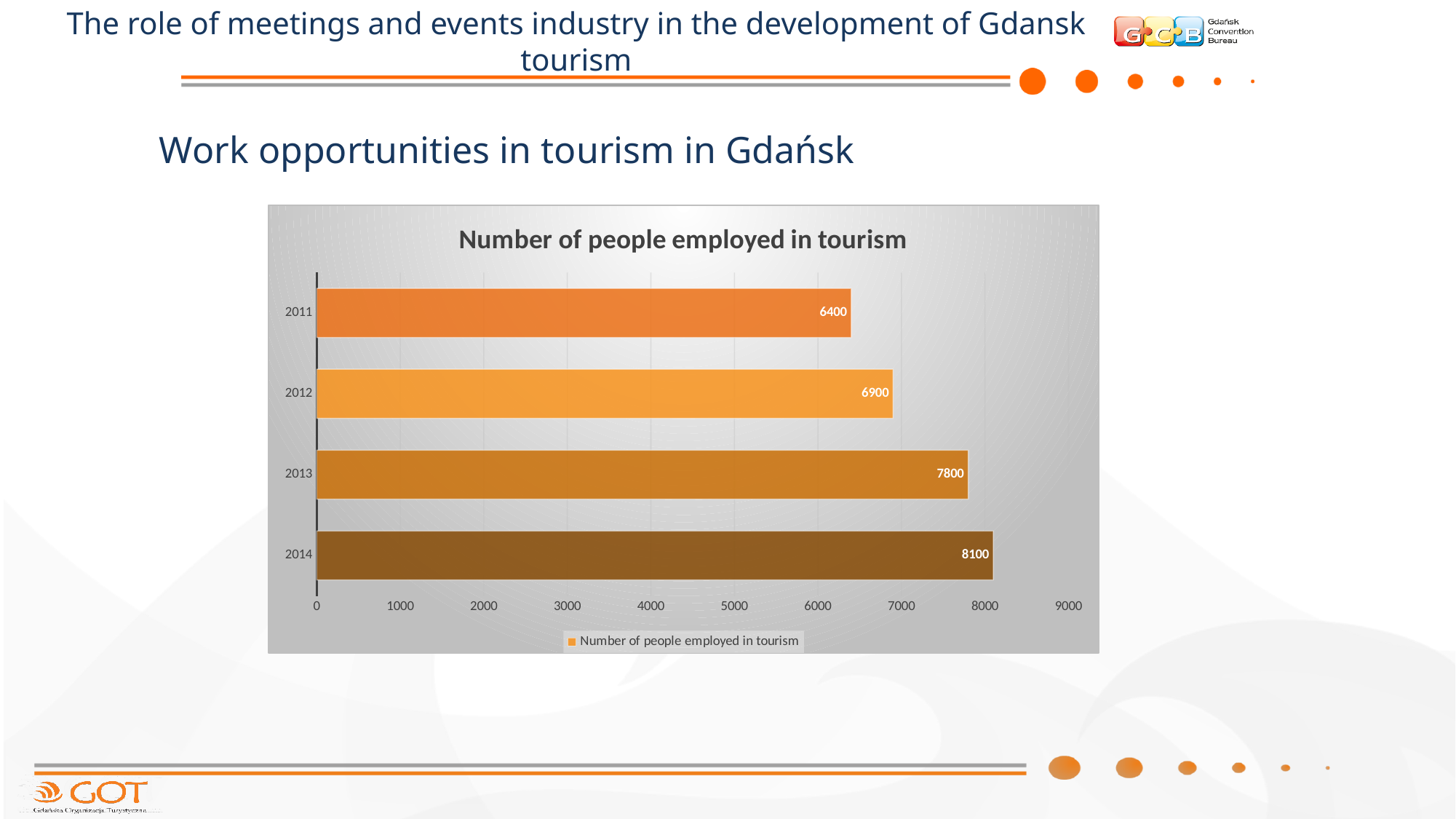
What is the difference between the number of people employed in tourism in 2013 and in 2012? 900 What is the number of people employed in tourism in 2011? 6400 What is the difference between the number of people employed in tourism in 2014 and in 2011? 1700 Is the value for 2012 greater or less than 7000? less What is the number of people employed in tourism in 2014? 8100 Which year has the highest number of people employed in tourism? 2014 What is the title of the chart? Number of people employed in tourism What kind of chart is shown on the slide? Bar chart What is the number of people employed in tourism in 2013? 7800 Which year has more people employed in tourism, 2012 or 2013? 2013 How many years are shown in the chart? 4 Which year has the lowest number of people employed in tourism? 2011